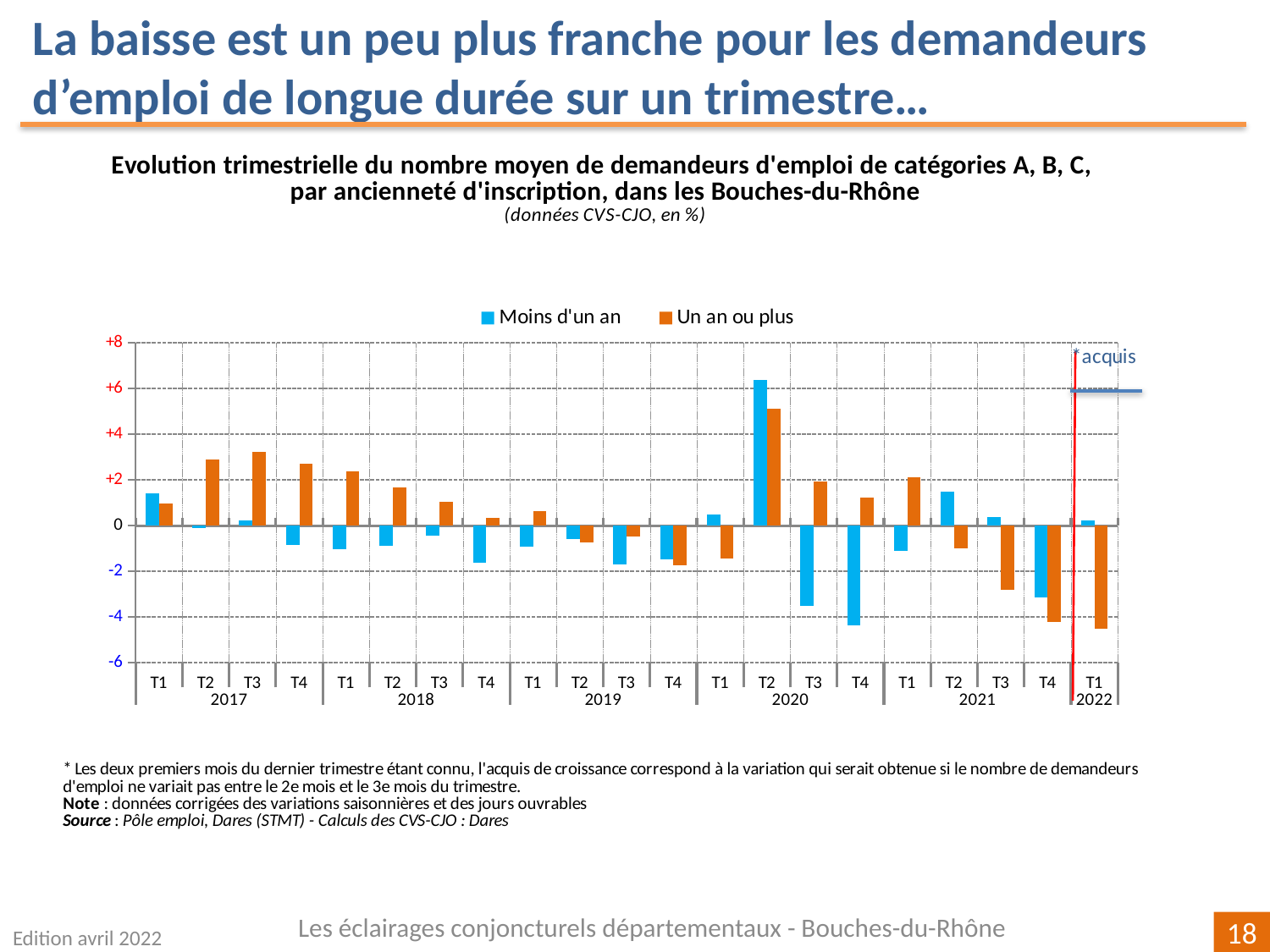
Is the 'Un an ou plus' value for T3 2017 greater or less than +2? greater Is the 'Moins d'un an' value for T2 2020 greater or less than +4? greater What kind of chart is shown on the slide? bar chart In which quarter is the 'Un an ou plus' bar the highest? T2 2020 What are the two series named in the legend? Moins d'un an; Un an ou plus Is the 'Un an ou plus' value for T1 2022 greater or less than -4? less In which quarter is the 'Moins d'un an' bar the lowest? T4 2020 In T3 2020, which series has the larger value, 'Moins d'un an' or 'Un an ou plus'? Un an ou plus In which quarter is the 'Moins d'un an' bar the highest? T2 2020 How many quarters are plotted on the x axis? 21 How many series does the legend list? 2